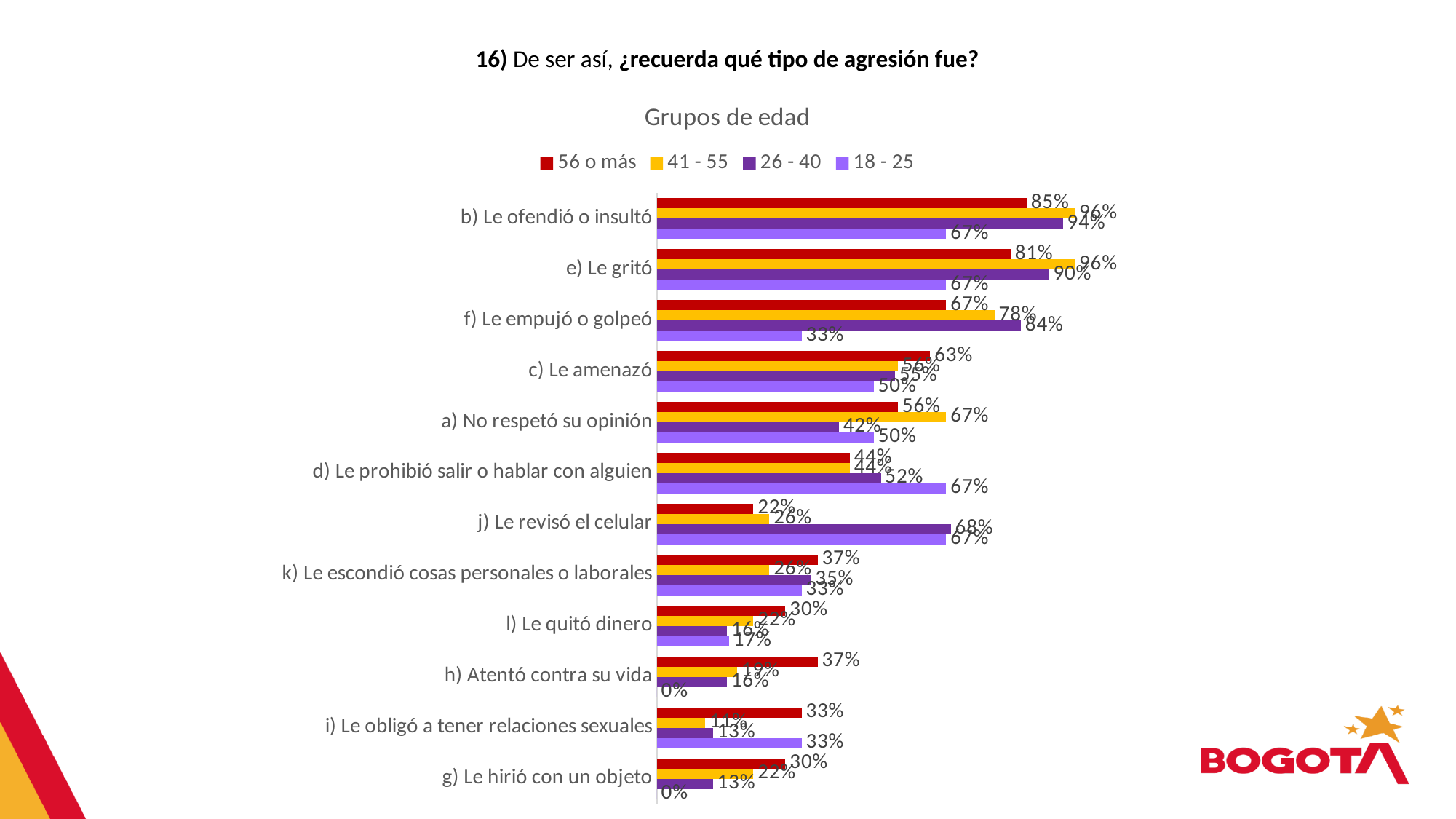
What is the value for the 18 - 25 group for 'f) Le empujó o golpeó'? 33% Which colour represents the 56 o más group in the legend? red What is the value for the 26 - 40 group for 'j) Le revisó el celular'? 68% For 'b) Le ofendió o insultó', what is the difference between the 41 - 55 value and the 18 - 25 value? 29 percentage points For 'f) Le empujó o golpeó', which group has the larger value: 26 - 40 or 41 - 55? 26 - 40 What type of chart is shown on the slide? bar chart How many series does the legend list? 4 For which category does the 56 o más group have its highest value? b) Le ofendió o insultó What is the value for the 56 o más group for 'h) Atentó contra su vida'? 37% For which category does the 56 o más group have its lowest value? j) Le revisó el celular What is the value for the 41 - 55 group for 'b) Le ofendió o insultó'? 96% How many categories (types of aggression) are plotted on the chart? 12